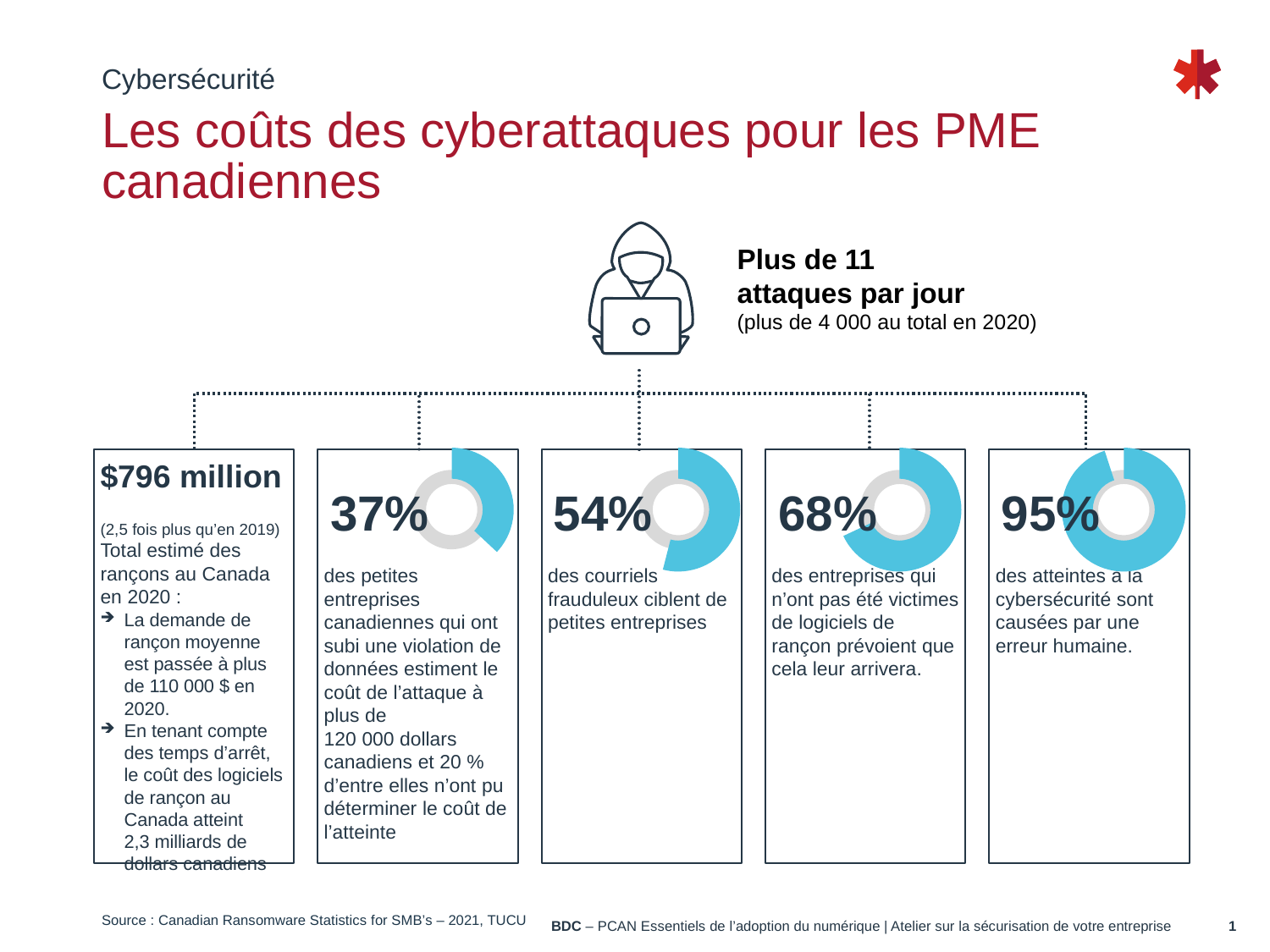
What is the difference between the percentage in the rightmost donut chart and the percentage in the leftmost donut chart? 58 percentage points Which of the four donut charts shows the lowest percentage? 37% (small businesses estimating attack cost above 120,000 CAD) What type of chart is used to display the 54% figure? Donut chart In the donut chart showing 95%, what share of the ring is filled in blue? 95% What colour is used for the filled portion of the donut charts? Blue What percentage is shown in the donut chart for businesses not yet hit by ransomware that expect it will happen to them? 68% What percentage is shown in the donut chart for fraudulent emails targeting small businesses? 54% What percentage is shown in the donut chart for cybersecurity breaches caused by human error? 95% Is the percentage in the second donut chart from the left (fraudulent emails) larger or smaller than the percentage in the third donut chart (businesses expecting ransomware)? smaller Which of the four donut charts shows the highest percentage? 95% (breaches caused by human error) How many donut charts are shown on the slide? 4 What percentage is shown in the donut chart for small Canadian businesses that suffered a data breach and estimate the attack cost at more than 120,000 Canadian dollars? 37%